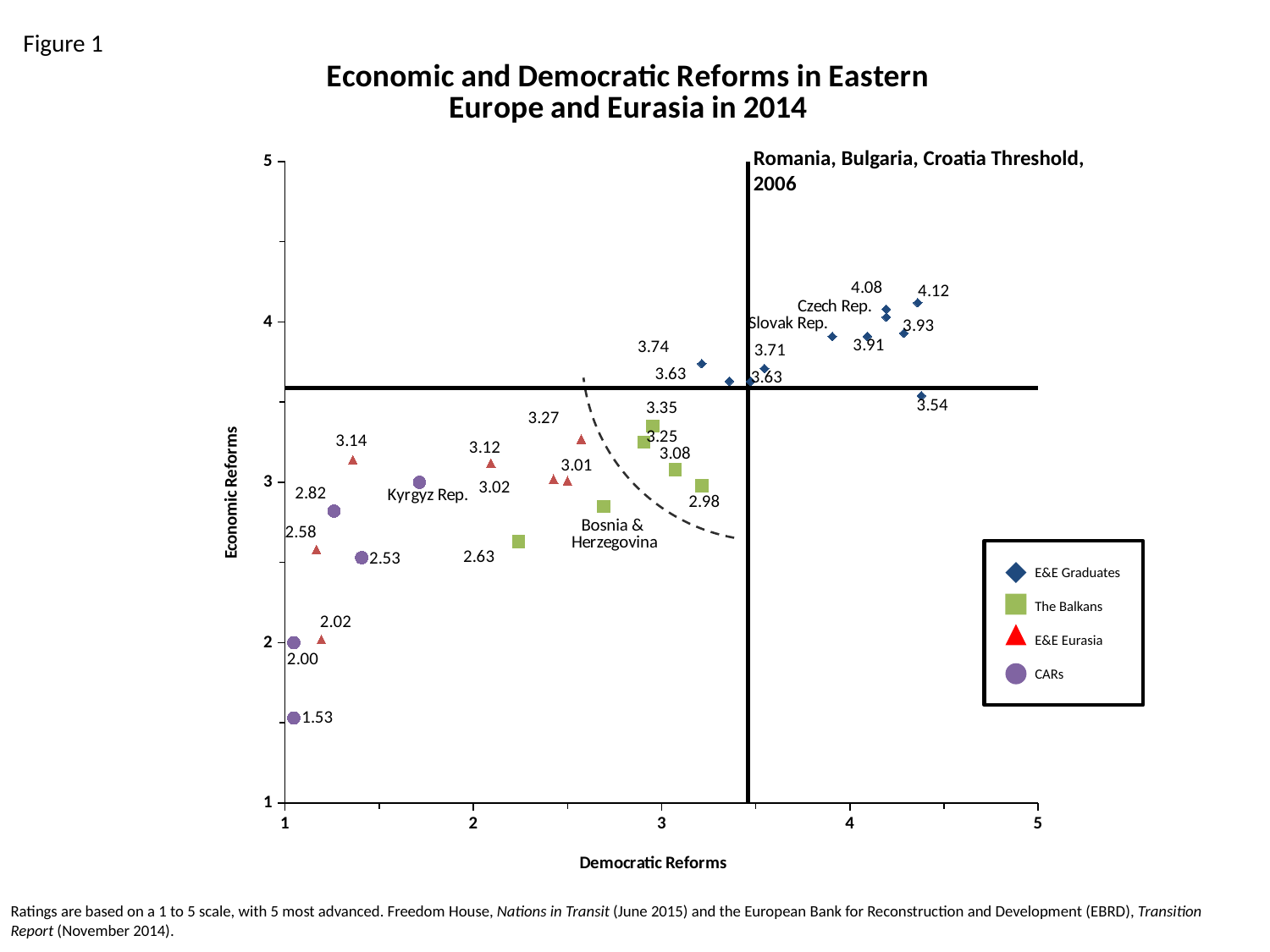
What label is given to the vertical threshold line on the chart? Romania, Bulgaria, Croatia Threshold, 2006 How many series does the legend list? 4 What is the title of the chart? Economic and Democratic Reforms in Eastern Europe and Eurasia in 2014 Which series contains the point with the lowest labeled Economic Reforms value (1.53)? CARs Is the Economic Reforms value for Bosnia & Herzegovina greater or less than 3? less What kind of chart is shown on the slide? scatter chart What is the lowest Economic Reforms value labeled on the chart? 1.53 Which series contains the point with the highest labeled Economic Reforms value (4.12)? E&E Graduates Is the Democratic Reforms value for Kyrgyz Rep. greater or less than 2? less What is the highest Economic Reforms value labeled on the chart? 4.12 How many CARs points are plotted on the chart? 5 What is the difference between the highest labeled value (4.12) and the lowest labeled value (1.53)? 2.59